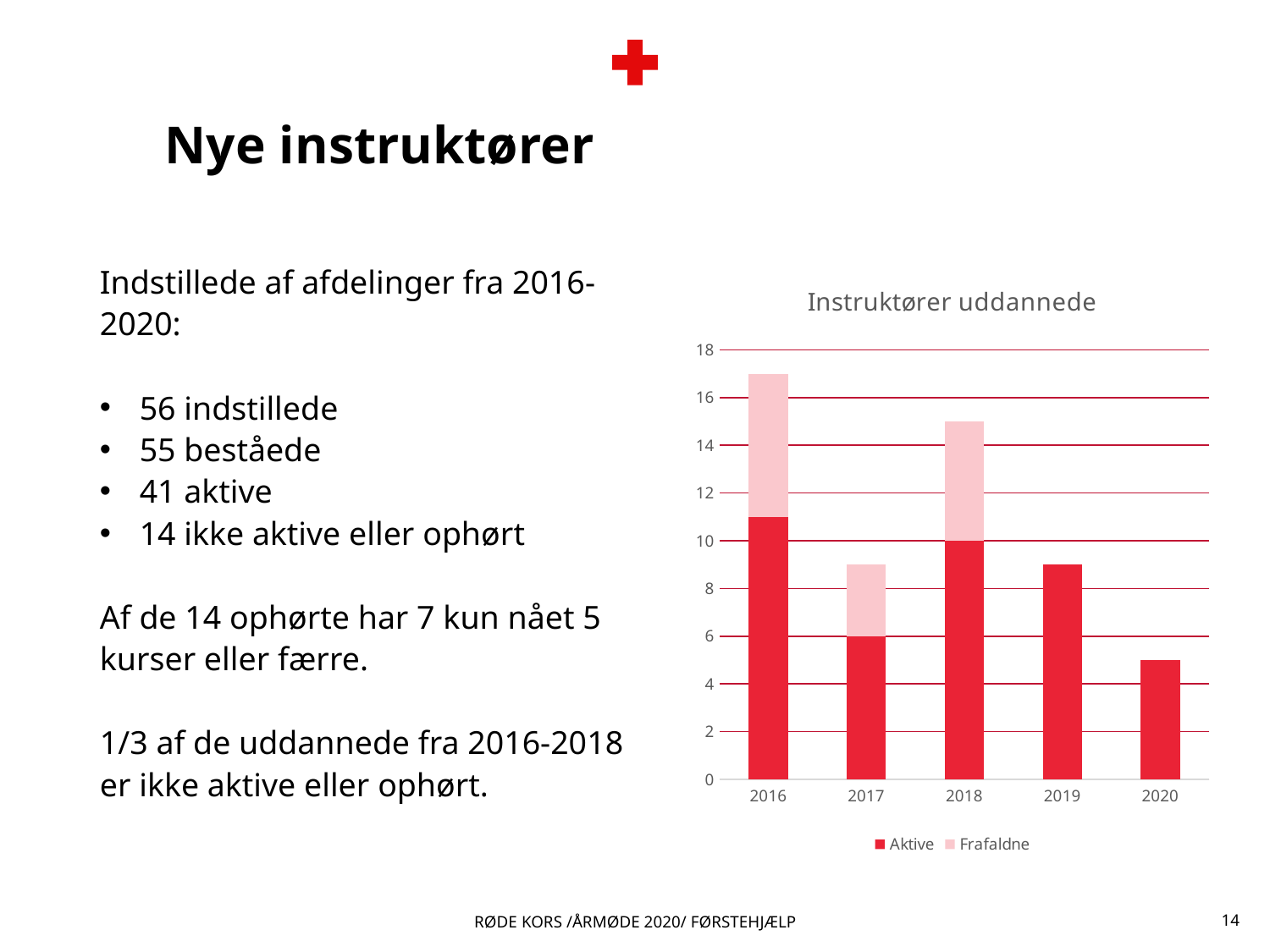
What is the value of Aktive for 2018? 10 What is the value of Aktive for 2017? 6 Which year has the tallest stacked bar in total? 2016 What are the two legend entries of the chart? Aktive and Frafaldne How many series does the legend of the chart list? 2 Which year has the larger total bar, 2018 or 2019? 2018 Is the total bar height for 2016 greater or less than 16? greater What kind of chart is shown on the slide? bar chart How many years are shown on the x axis of the chart? 5 Is the value for 2020 greater or less than 6? less What is the title of the chart? Instruktører uddannede Which year has the shortest bar in total? 2020